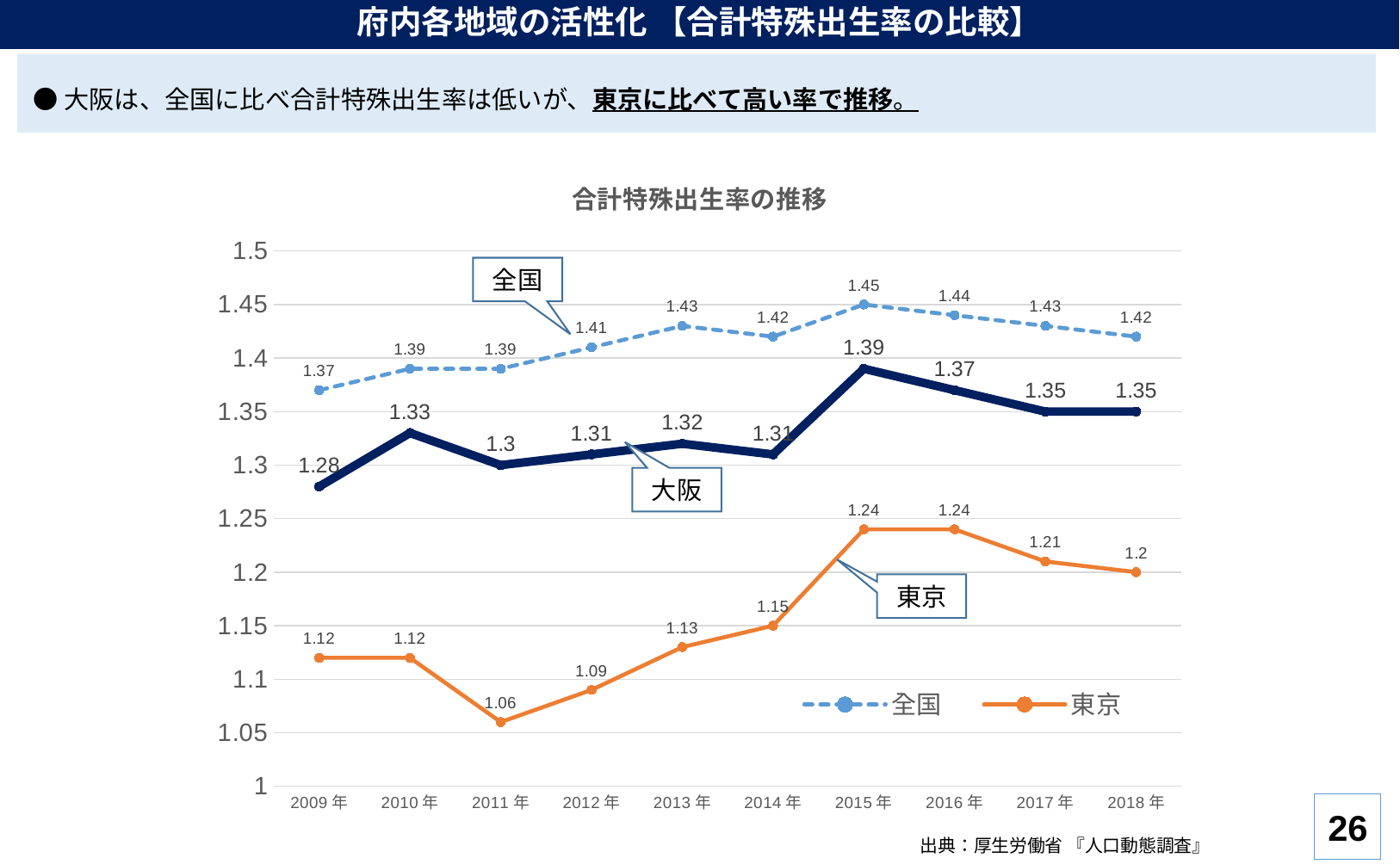
What is the value for 大阪 in 2015年? 1.39 What is the difference between the 全国 and 大阪 values in 2009年? 0.09 What is the value for 東京 in 2011年? 1.06 In which year is the 東京 value lowest? 2011年 What type of chart is shown on the slide? Line chart What is the value for 全国 in 2018年? 1.42 Does the 東京 value rise or fall from 2016年 to 2018年? Fall How many series does the legend list? 2 In which year is the 全国 value highest? 2015年 How many years are shown on the x axis? 10 What is the title of the chart? 合計特殊出生率の推移 Which is larger in 2016年, the 大阪 value or the 東京 value? 大阪